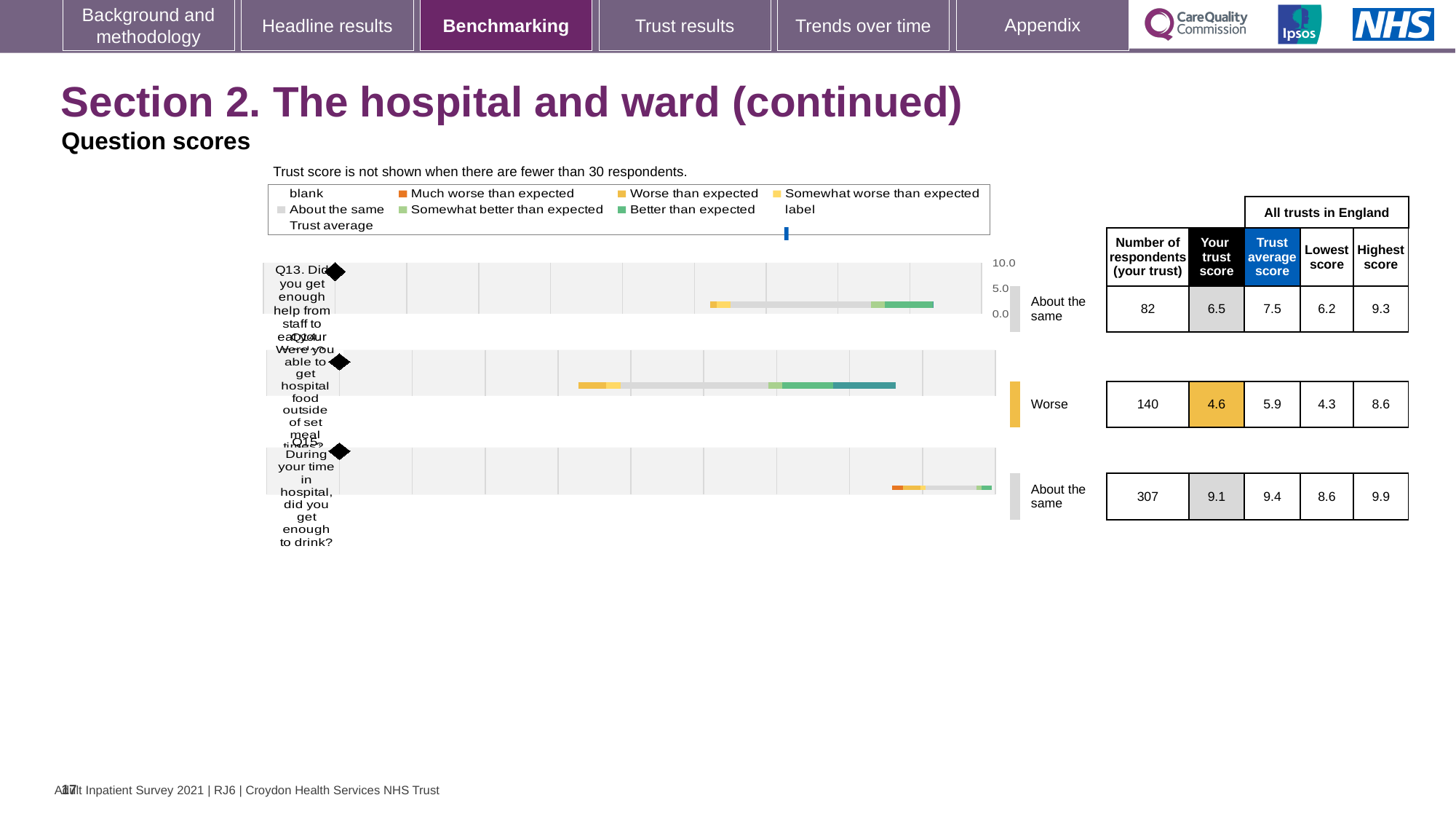
Which question has the lowest trust score? Q14 Which question is rated 'Worse' than expected for this trust? Q14 What is the trust score for Q14 (Were you able to get hospital food outside of set meal times?)? 4.6 How many survey questions are plotted in the chart? 3 How many respondents answered Q15 (did you get enough to drink?) for this trust? 307 What is the highest score across all trusts in England for Q13? 9.3 What kind of chart is used to show the question scores on this slide? bar chart For Q13, which is larger: the trust's own score or the trust average score? Trust average score For Q14, what is the difference between the trust average score and this trust's score? 1.3 What is the lowest score across all trusts in England for Q15? 8.6 Which question has the highest trust score? Q15 What is the maximum value shown on the chart's score axis? 10.0